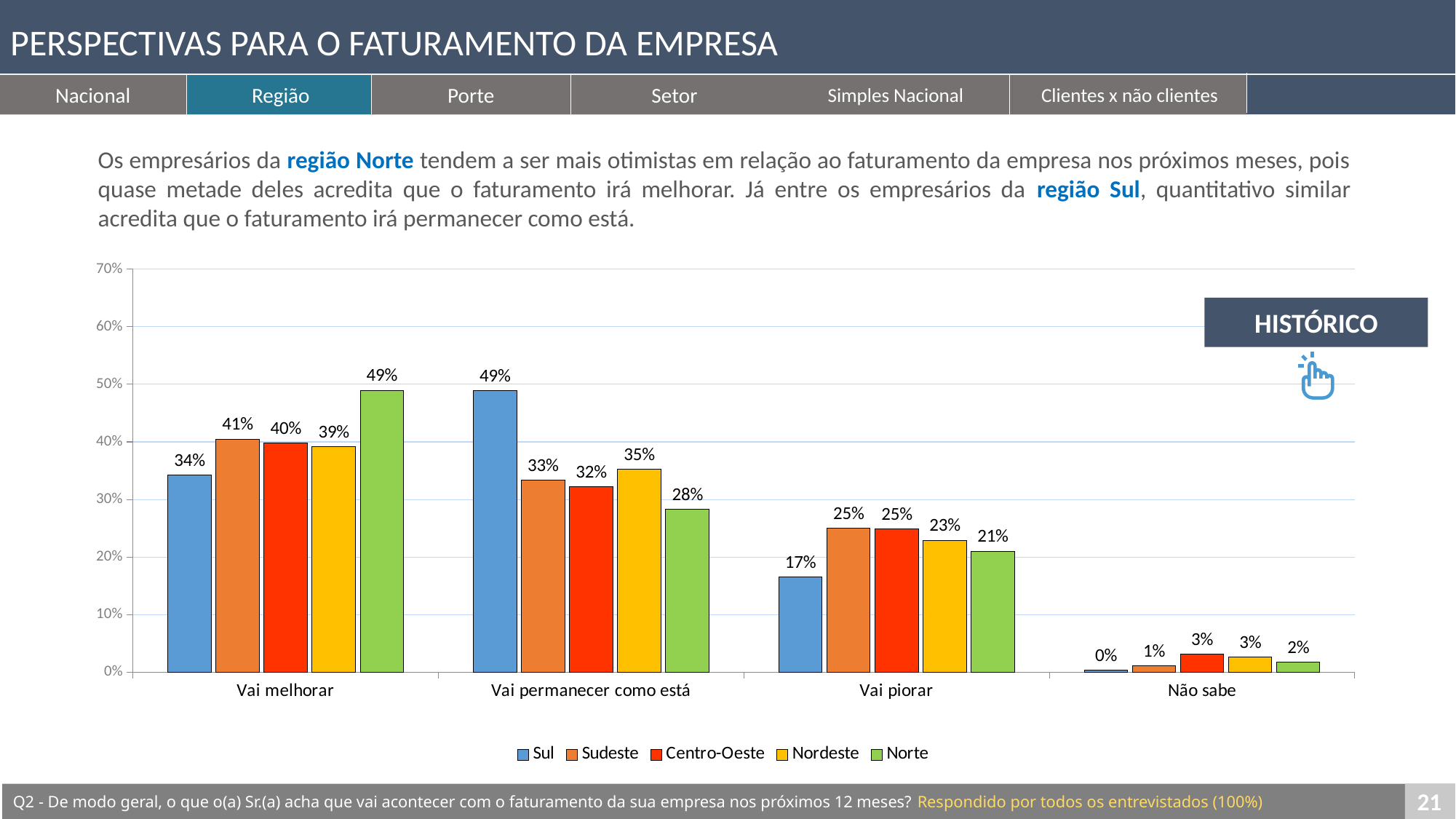
In the "Vai melhorar" category, which is larger: Sudeste or Sul? Sudeste Is the value for Norte in the "Vai piorar" category greater or less than 30%? less What is the difference between Sul and Norte in the "Vai permanecer como está" category? 21% What is the value for Sul in the "Vai permanecer como está" category? 49% Which region has the lowest value in the "Vai piorar" category? Sul What is the value for Norte in the "Vai melhorar" category? 49% What colour represents the Norte series in the chart? Green How many series does the legend list? 5 How many response categories are shown on the x axis? 4 What is the value for Nordeste in the "Vai piorar" category? 23% Which region has the highest value in the "Vai melhorar" category? Norte What kind of chart is shown on the slide? Bar chart